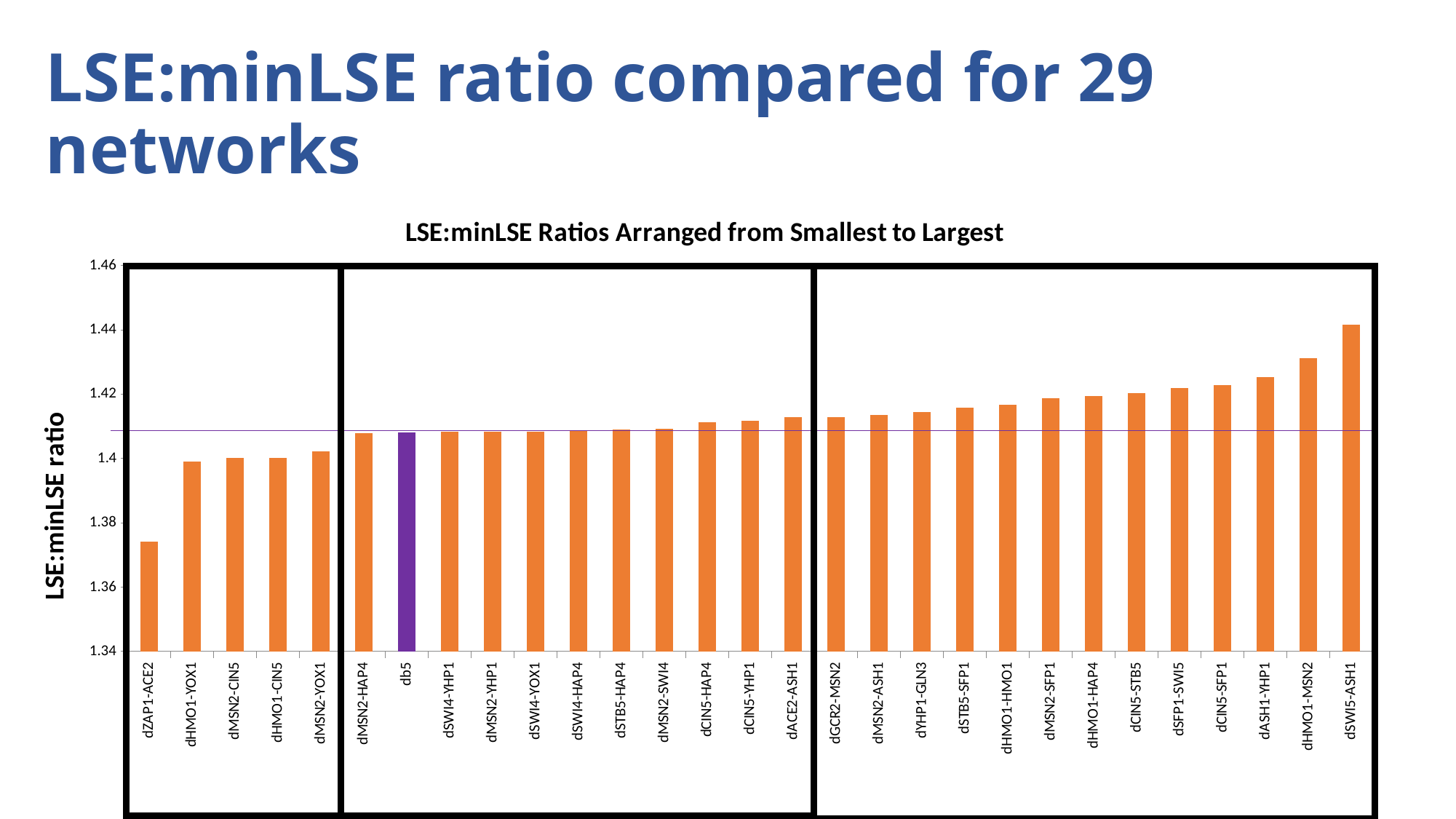
Which bar is coloured purple instead of orange? db5 Is the value for dMSN2-HAP4 greater or less than 1.40? greater Which has the larger LSE:minLSE ratio, dHMO1-MSN2 or dGCR2-MSN2? dHMO1-MSN2 Is the value for dZAP1-ACE2 greater or less than 1.38? less How many networks (bars) are plotted in the chart? 29 Do the values rise or fall moving from left to right along the x axis? rise What is the title of the chart? LSE:minLSE Ratios Arranged from Smallest to Largest Which network has the lowest LSE:minLSE ratio? dZAP1-ACE2 Which network has the highest LSE:minLSE ratio? dSWI5-ASH1 Is the value for dHMO1-MSN2 greater or less than 1.42? greater What kind of chart is shown on the slide? bar chart